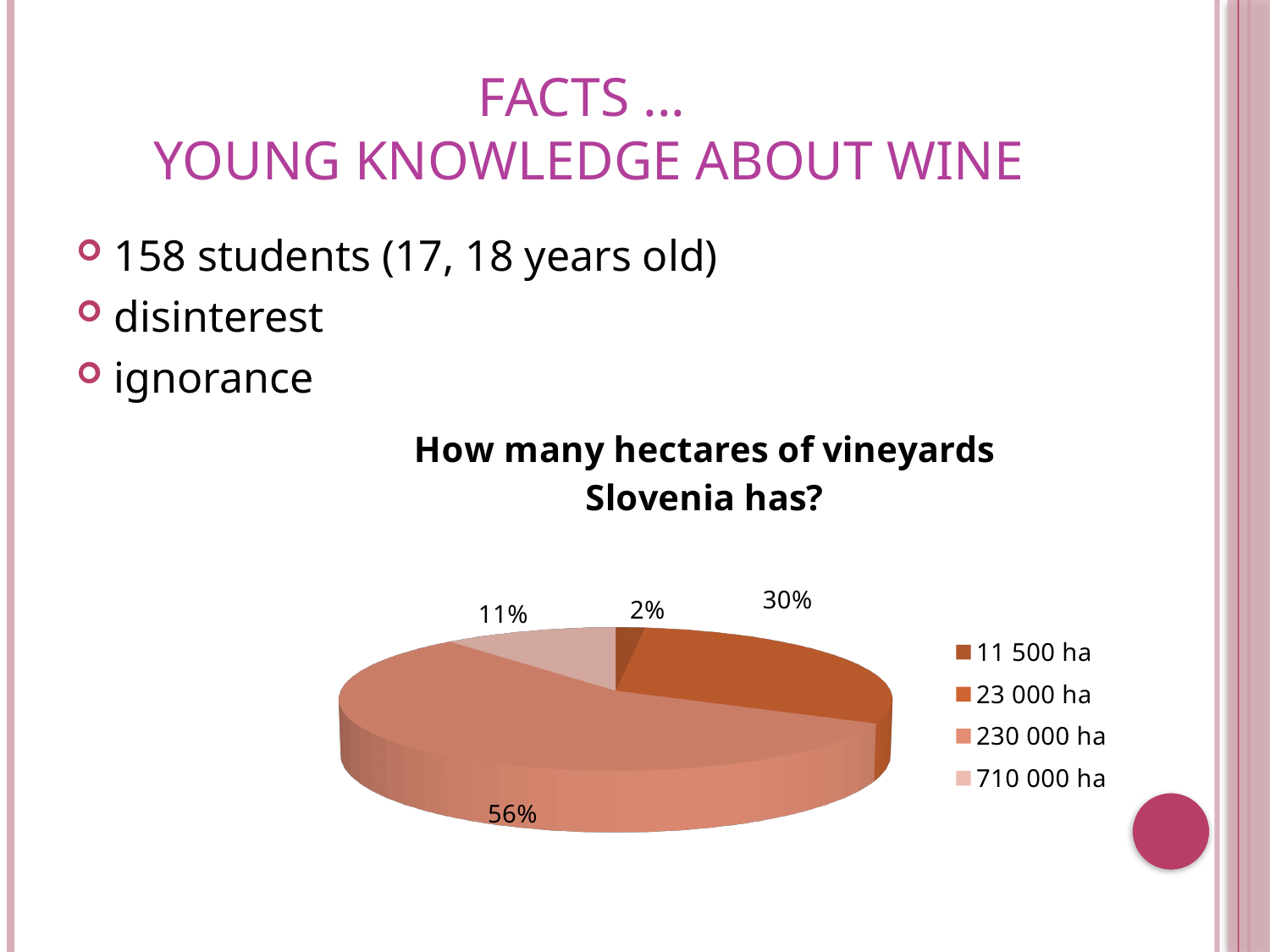
Which answer has the smallest share of the pie? 11 500 ha Which answer has the largest share of the pie? 230 000 ha What type of chart is shown on the slide? pie chart Which has a larger share of the pie, 710 000 ha or 23 000 ha? 23 000 ha What is the difference in percentage points between the 230 000 ha share and the 23 000 ha share? 26 What share of the pie does the 11 500 ha answer have? 2% What share of the pie does the 23 000 ha answer have? 30% What share of the pie does the 710 000 ha answer have? 11% What is the title of the chart? How many hectares of vineyards Slovenia has? How many categories does the chart's legend list? 4 How many slices does the pie chart have? 4